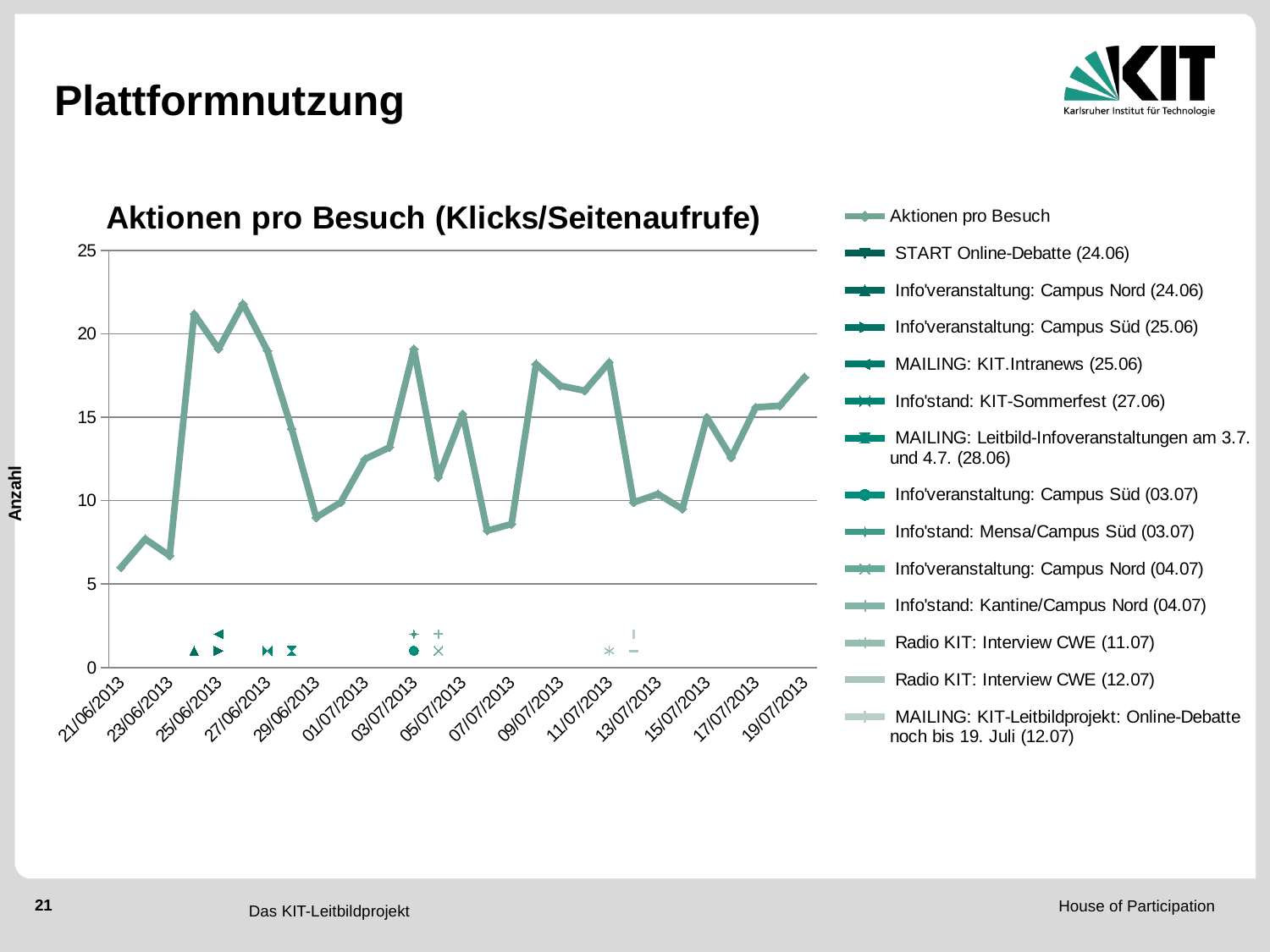
Is the value for 07/07/2013 greater or less than 10? less Which has the higher value, 25/06/2013 or 21/06/2013? 25/06/2013 How many entries does the chart's legend list? 14 What kind of chart is shown on the slide? line chart Is the value for 25/06/2013 greater or less than 20? less What is the title of the chart? Aktionen pro Besuch (Klicks/Seitenaufrufe) Is the value for 19/07/2013 greater or less than 15? greater Which has the higher value, 03/07/2013 or 07/07/2013? 03/07/2013 What is the label of the vertical axis? Anzahl Does the line rise or fall between 21/06/2013 and 25/06/2013? rise